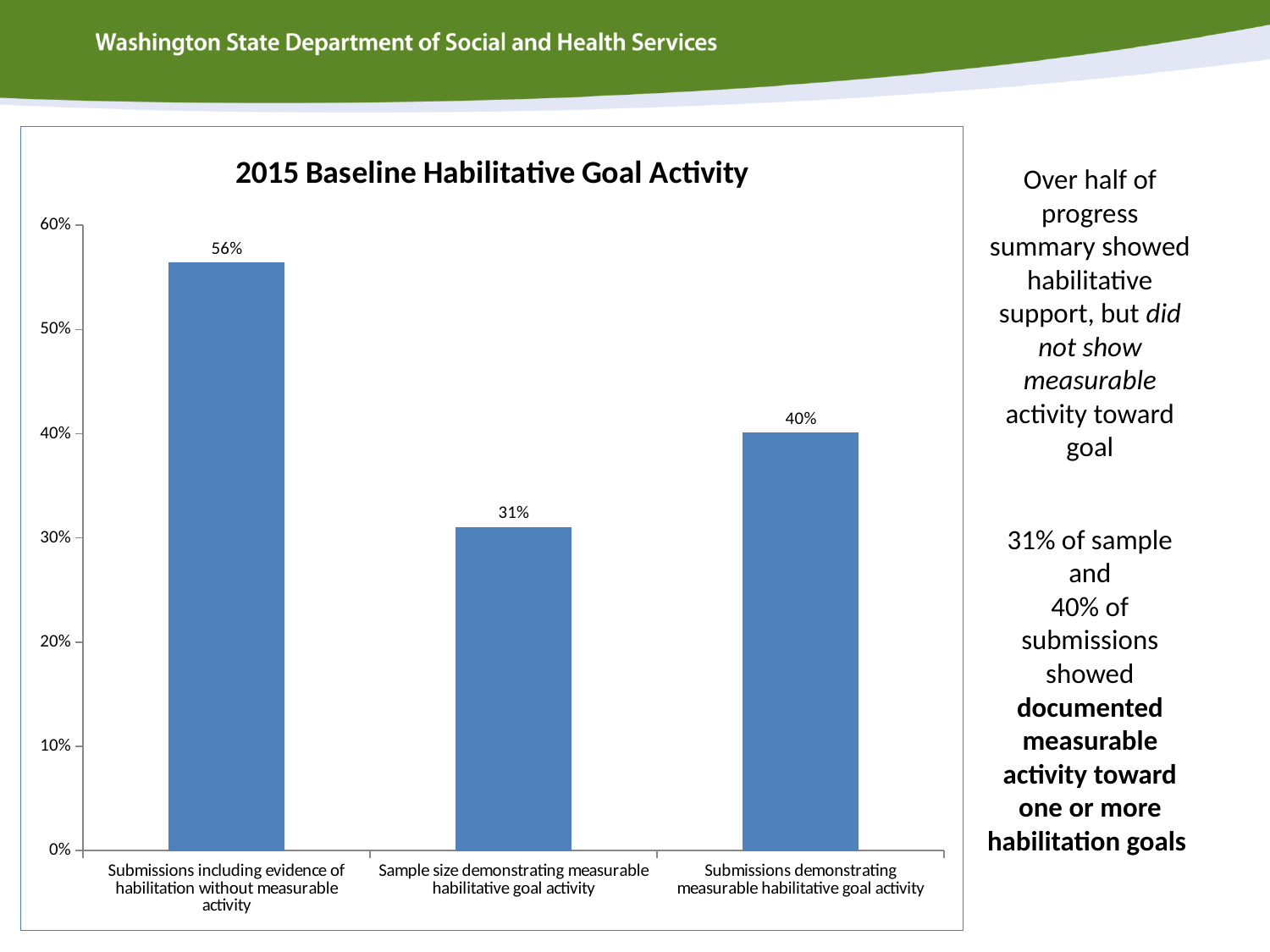
What is the title of the chart? 2015 Baseline Habilitative Goal Activity What is the value for 'Submissions including evidence of habilitation without measurable activity'? 56% What kind of chart is shown on the slide? Bar chart What is the difference between the values for 'Submissions including evidence of habilitation without measurable activity' and 'Submissions demonstrating measurable habilitative goal activity'? 16% Which category has the highest value? Submissions including evidence of habilitation without measurable activity How many categories are shown in the chart? 3 Which category has the lowest value? Sample size demonstrating measurable habilitative goal activity What is the difference between the values for 'Submissions demonstrating measurable habilitative goal activity' and 'Sample size demonstrating measurable habilitative goal activity'? 9% What is the value for 'Submissions demonstrating measurable habilitative goal activity'? 40% Which is larger: the value for 'Sample size demonstrating measurable habilitative goal activity' or 'Submissions demonstrating measurable habilitative goal activity'? Submissions demonstrating measurable habilitative goal activity What is the value for 'Sample size demonstrating measurable habilitative goal activity'? 31% Is the value for 'Submissions including evidence of habilitation without measurable activity' greater or less than 50%? greater